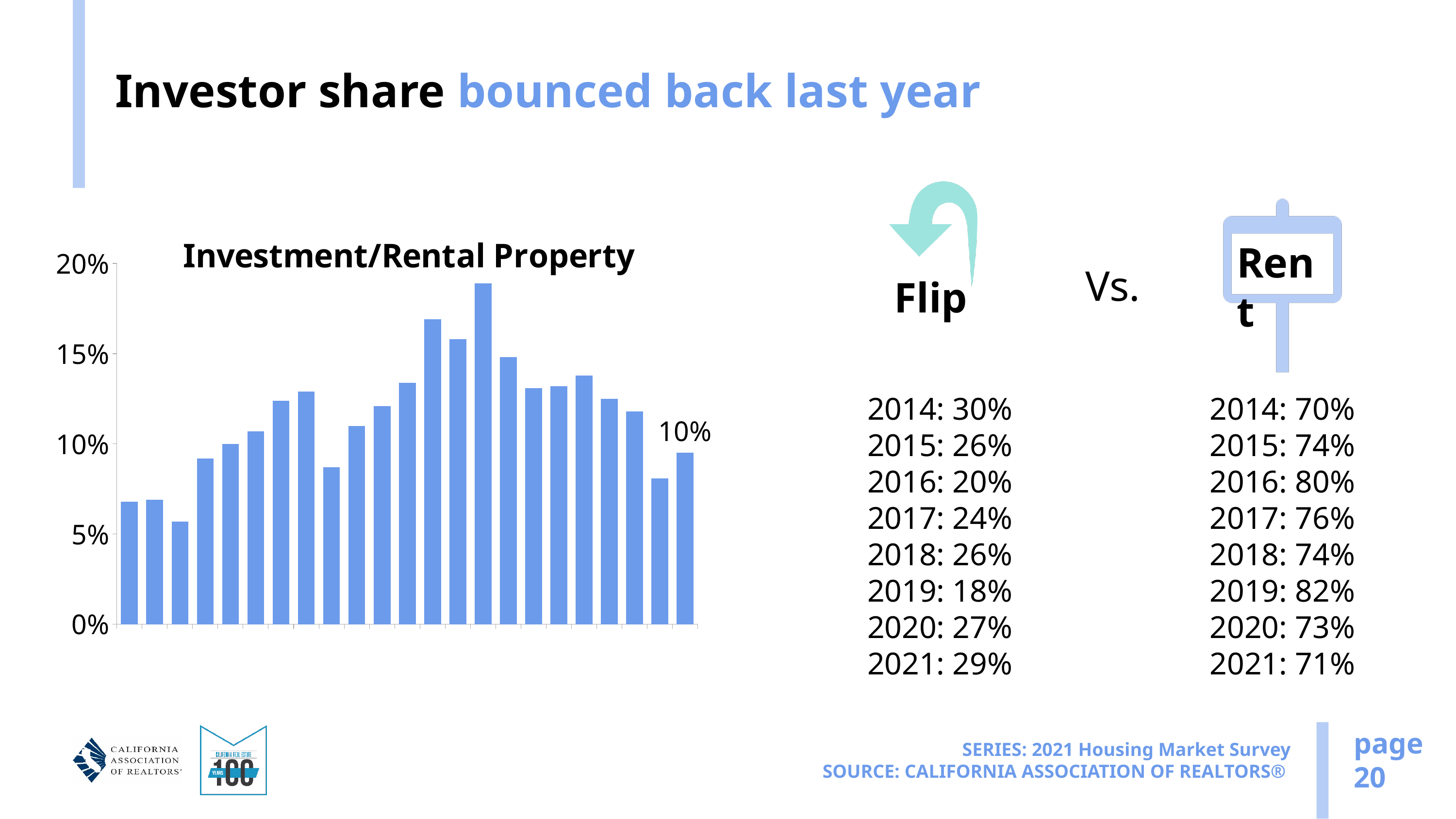
What value is printed as the data label on the last (rightmost) bar of the Investment/Rental Property chart? 10% How many bars are plotted in the Investment/Rental Property chart? 23 What is the title of the chart on the slide? Investment/Rental Property What kind of chart is the Investment/Rental Property chart? bar chart Is the second-to-last bar in the Investment/Rental Property chart greater or less than 10%? less What is the highest value shown on the y axis of the Investment/Rental Property chart? 20% In the Investment/Rental Property chart, is the last bar taller or shorter than the bar immediately before it? taller Is the shortest bar in the Investment/Rental Property chart greater or less than 10%? less Is the tallest bar in the Investment/Rental Property chart greater or less than 15%? greater Does the value rise or fall from the second-to-last bar to the last bar in the Investment/Rental Property chart? rise